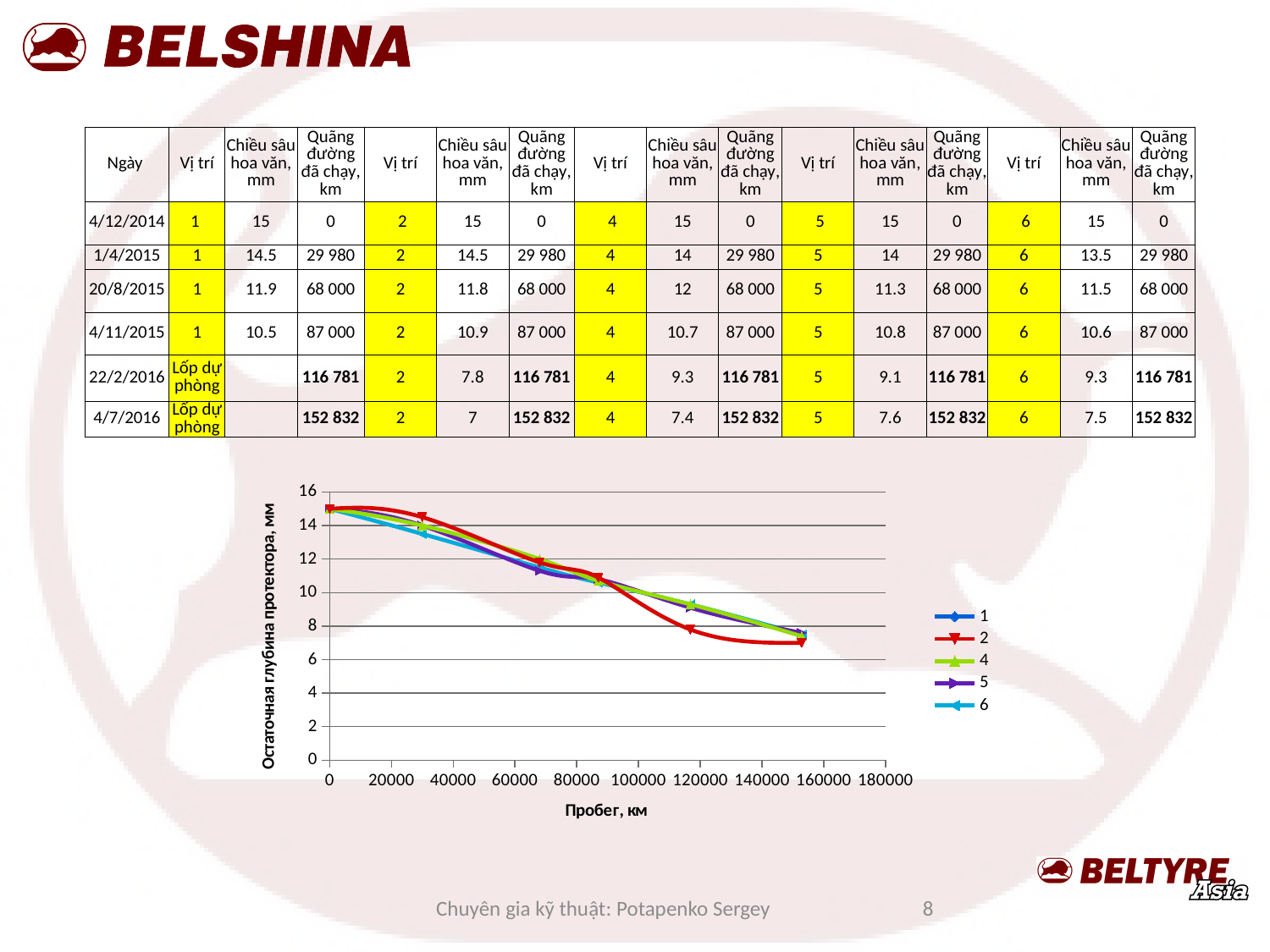
How many data points are plotted for series 2? 6 Do the plotted tread depth values rise or fall as mileage increases along the x axis? fall Is the value for series 2 at 152 832 km greater or less than 8? less What is the title of the chart's x axis? Пробег, км How many series does the chart legend list? 5 Is the value for series 1 at 0 km greater or less than 14? greater By how much does the tread depth of series 4 decrease between 0 km and 152 832 km? 7.6 What type of chart is shown on the slide? line chart What are the series names listed in the chart legend? 1, 2, 4, 5, 6 Which series has the lowest tread depth at the final mileage point (152 832 km)? 2 What is the tread depth for series 4 at 152 832 km? 7.4 What is the tread depth for series 2 at 116 781 km? 7.8